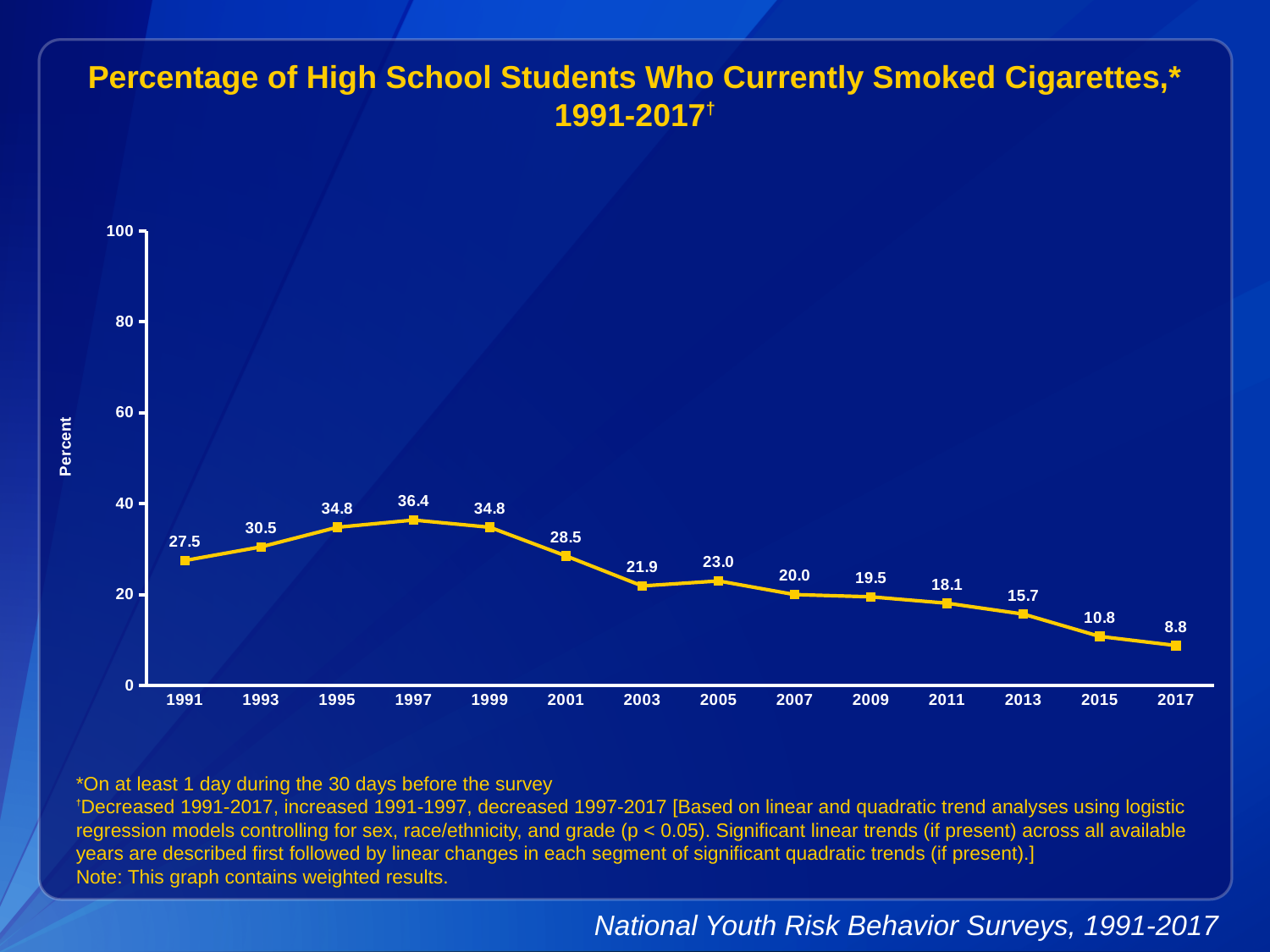
Which year has a higher value, 2003 or 2005? 2005 What is the difference between the 1997 value and the 2017 value? 27.6 What percentage of high school students currently smoked cigarettes in 1997? 36.4 What is the value plotted for 2017? 8.8 Do the values rise or fall from 1997 to 2017? fall Which year has the lowest percentage? 2017 How many years are plotted on the x axis? 14 What is the label on the y axis? Percent What is the value plotted for 1991? 27.5 What kind of chart is shown? line chart Is the value for 2001 greater or less than 20? greater Which year has the highest percentage? 1997